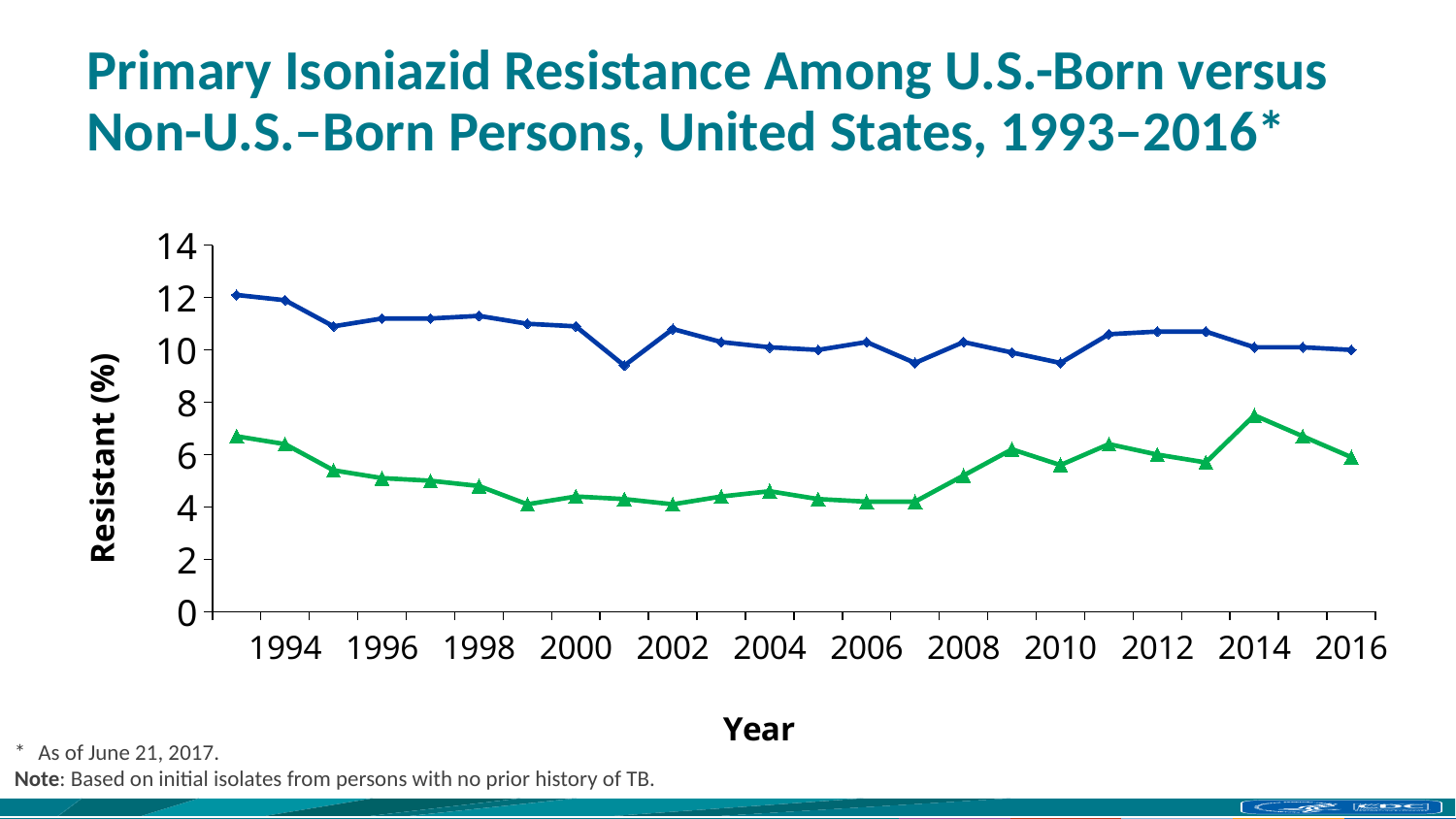
Is the value of the green line in 2014 greater or less than 6? greater Is the value of the green line in 1993 greater or less than 6? greater Is the value of the blue line in 1998 greater or less than 10? greater What is the label of the vertical axis? Resistant (%) What is the label of the horizontal axis? Year In which year does the green line reach its highest value? 2014 What kind of chart is shown on the slide? Line chart Does the green line rise or fall between 1993 and 1999? Fall In 2016, which line has the higher value, the blue line or the green line? The blue line How many lines are plotted on the chart? 2